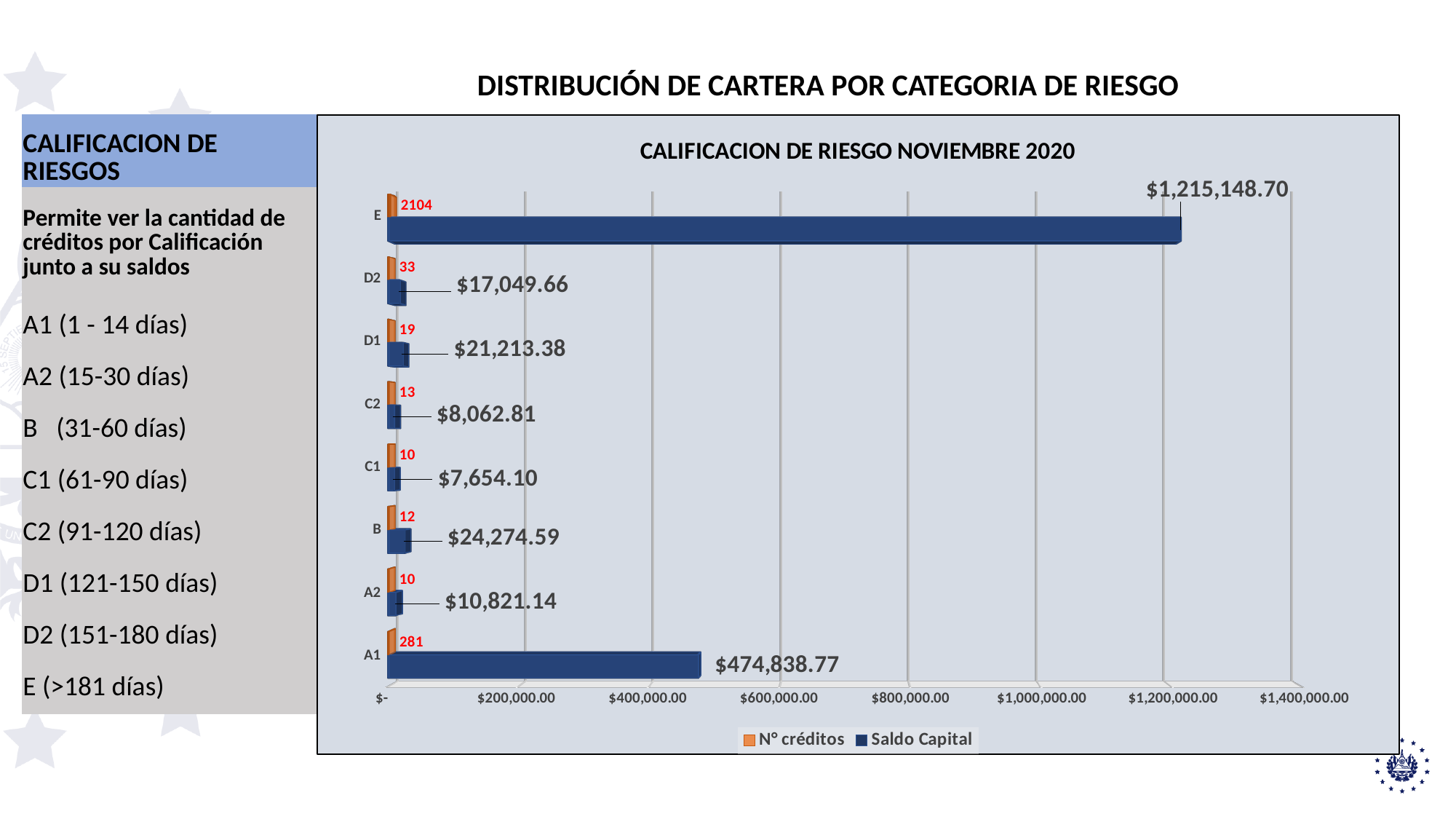
What is the Saldo Capital value for category B? $24,274.59 What kind of chart is shown on the slide? Bar chart Which has a larger Saldo Capital, A1 or E? E What is the Saldo Capital value for category E? $1,215,148.70 How many categories are shown on the chart? 8 Which category has the lowest N° créditos? A2 and C1 (both 10) What is the N° créditos value for category D2? 33 What is the N° créditos value for category A1? 281 What is the difference in Saldo Capital between D1 and D2? $4,163.72 Which category has the highest Saldo Capital? E How many series does the legend list? 2 Which category has the lowest Saldo Capital? C1